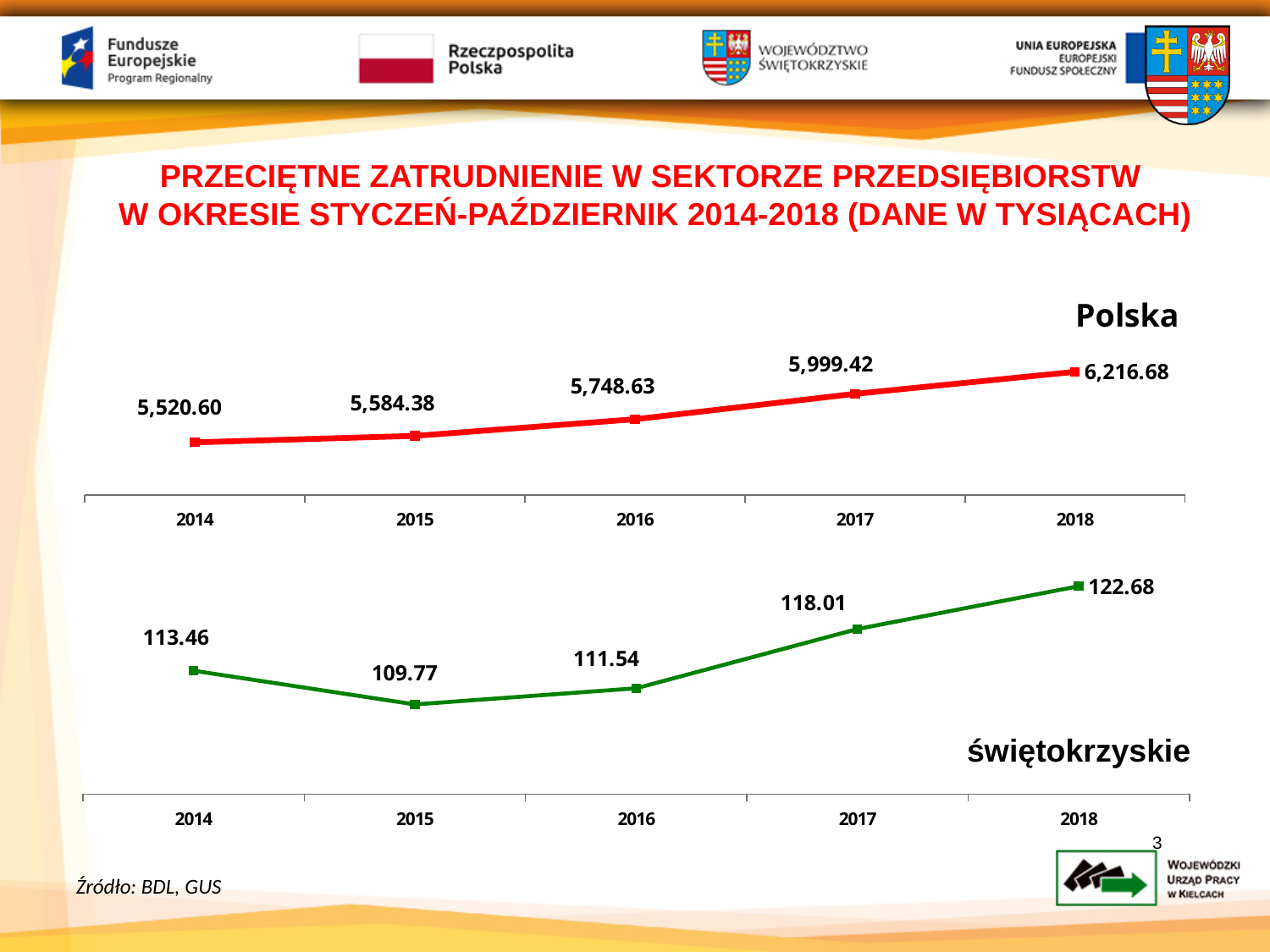
In the świętokrzyskie chart, which is larger, the value for 2014 or the value for 2016? 2014 In the Polska chart, what is the difference between the 2018 and 2014 values? 696.08 What type of chart is the świętokrzyskie chart? Line chart In the świętokrzyskie chart, which year has the lowest value? 2015 How many years are plotted in the Polska chart? 5 In the świętokrzyskie chart, what is the difference between the 2018 and 2015 values? 12.91 In the świętokrzyskie chart, which year has the highest value? 2018 In the Polska chart, which year has the highest value? 2018 In the Polska chart, what is the value for 2014? 5,520.60 In the świętokrzyskie chart, what is the value for 2017? 118.01 In the Polska chart, do the values rise or fall from 2014 to 2018? Rise In the Polska chart, what is the value for 2016? 5,748.63